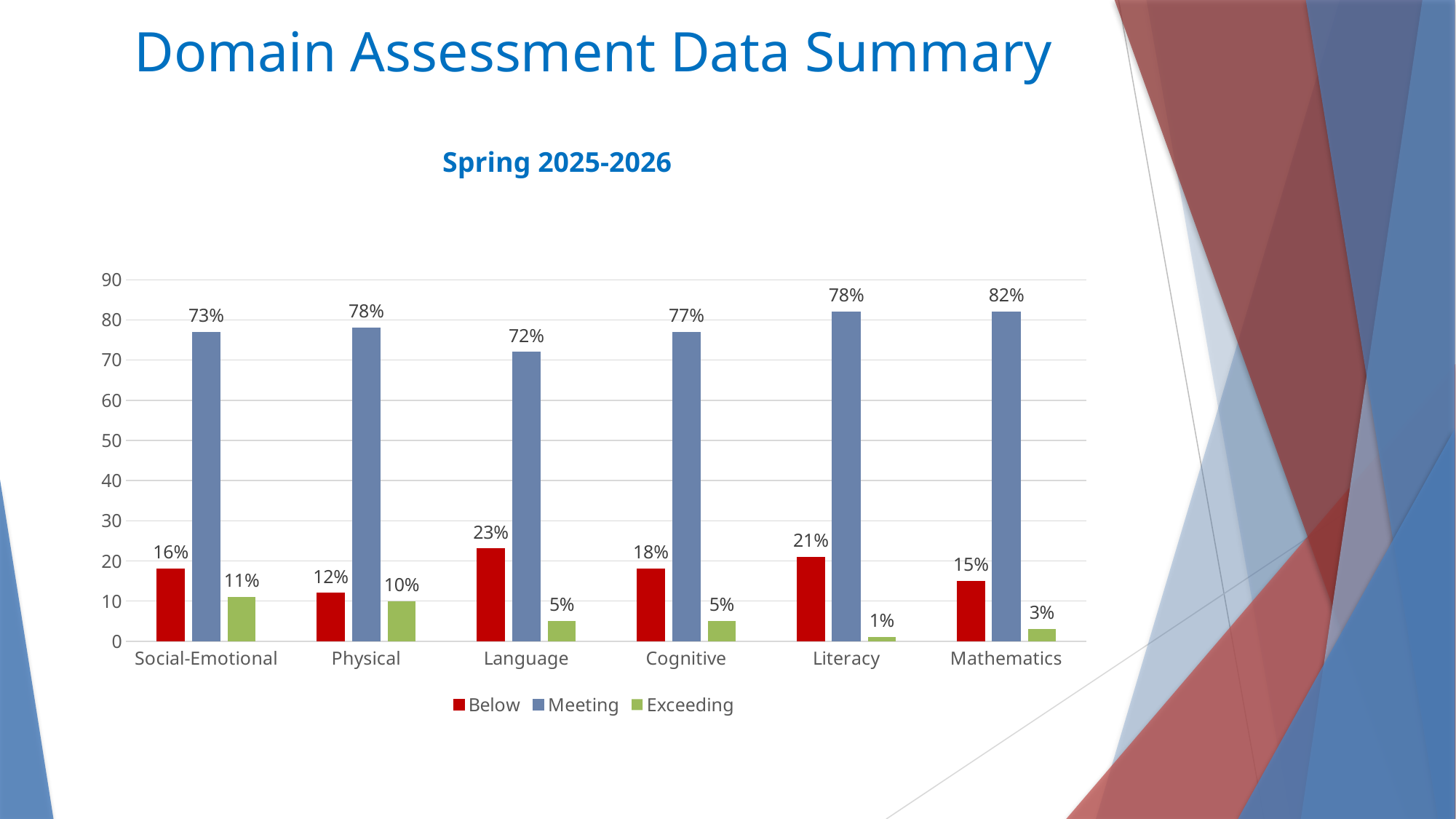
What is the Exceeding value for Social-Emotional? 11% What is the title of the chart? Spring 2025-2026 What kind of chart is shown on the slide? Bar chart Which domain has the lowest Below value? Physical What is the difference between the Meeting values for Mathematics and Language? 10% What is the Below value for Language? 23% What is the Meeting value for Mathematics? 82% How many domains are shown on the x axis? 6 Which domain has the lowest Exceeding value? Literacy Which is larger, the Below value for Literacy or the Below value for Cognitive? Literacy Which domain has the highest Meeting value? Mathematics How many series does the legend list? 3